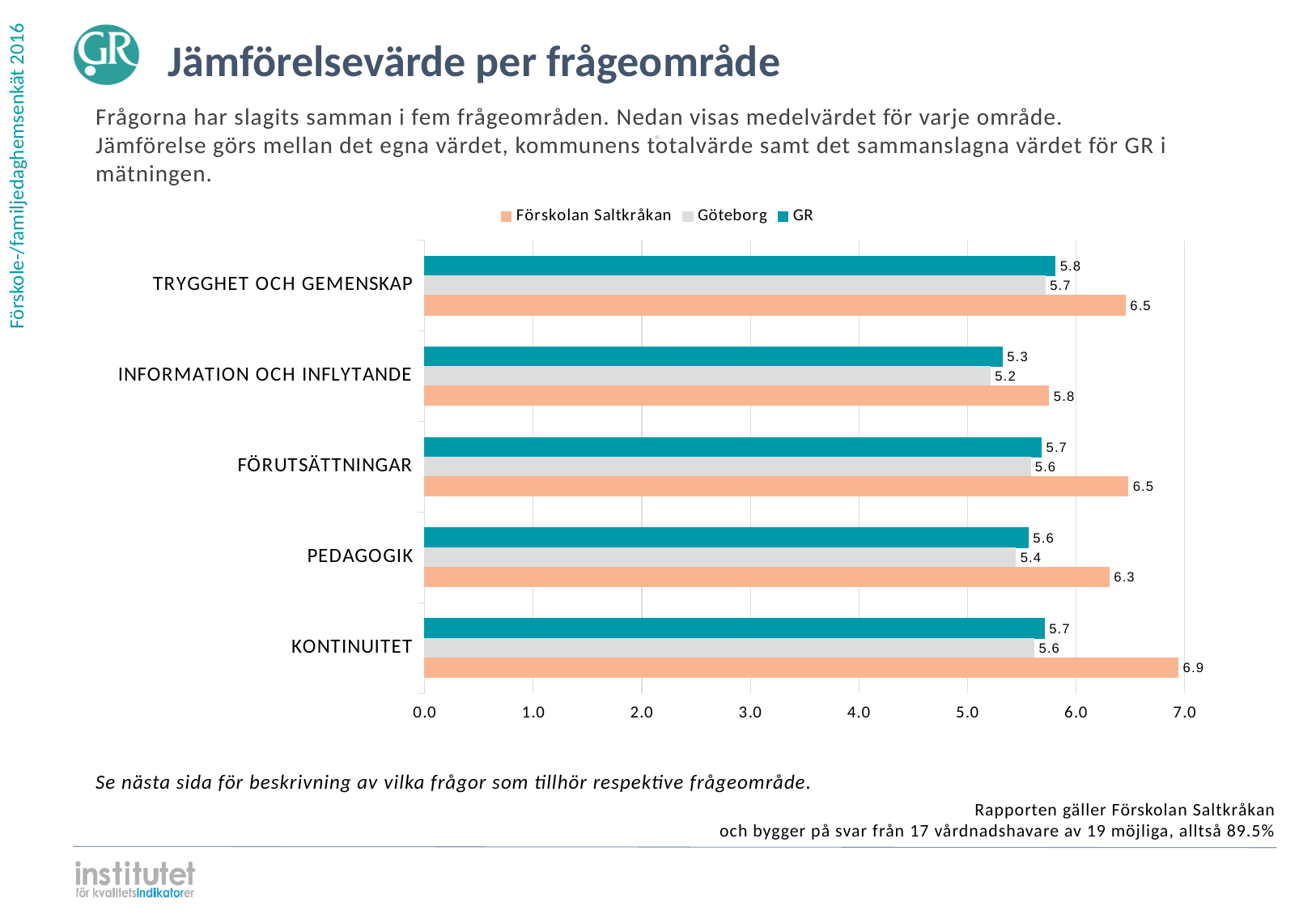
What is the value for Göteborg in the PEDAGOGIK category? 5.4 What kind of chart is shown on the slide? bar chart What is the value for GR in the INFORMATION OCH INFLYTANDE category? 5.3 How many categories are shown on the chart? 5 How many series does the legend list? 3 What is the value for Förskolan Saltkråkan in the KONTINUITET category? 6.9 Is the value for Förskolan Saltkråkan in the FÖRUTSÄTTNINGAR category greater or less than 6.0? greater Which category has the highest value for Förskolan Saltkråkan? KONTINUITET Which is larger in the PEDAGOGIK category: the value for Förskolan Saltkråkan or the value for GR? Förskolan Saltkråkan Which series is shown in orange in the legend? Förskolan Saltkråkan What is the difference between the Förskolan Saltkråkan value and the Göteborg value in the TRYGGHET OCH GEMENSKAP category? 0.8 Which category has the lowest value for Göteborg? INFORMATION OCH INFLYTANDE